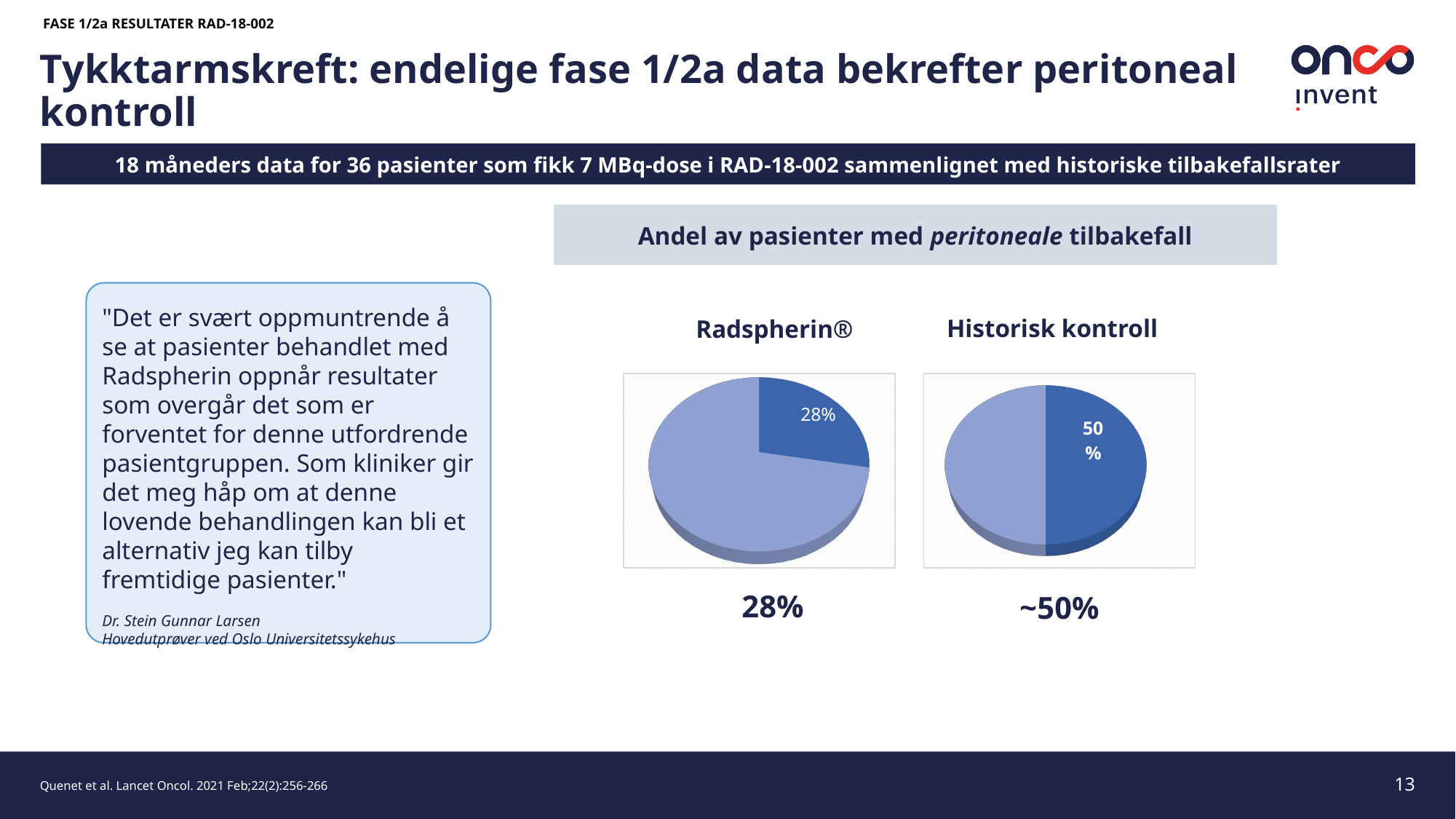
Which pie chart has the larger dark blue slice, Radspherin® or Historisk kontroll? Historisk kontroll What is the title shown in the shaded box above the two pie charts? Andel av pasienter med peritoneale tilbakefall How many pie charts are shown on the slide? 2 How many slices does the Radspherin® pie chart have? 2 In the Radspherin® pie chart, is the dark blue slice greater or less than 50%? less In the Radspherin® pie chart, which slice is larger, the dark blue slice or the light blue slice? the light blue slice What is the difference in percentage points between the labeled slice in the Historisk kontroll pie chart (50%) and the labeled slice in the Radspherin® pie chart (28%)? 22 percentage points In the Radspherin® pie chart, what percentage is labeled on the dark blue slice? 28% What value is printed in large text below the Radspherin® pie chart? 28% What value is printed in large text below the Historisk kontroll pie chart? ~50% What kind of chart is shown under the heading "Radspherin®"? pie chart In the Historisk kontroll pie chart, what percentage is labeled on the dark blue slice? 50%